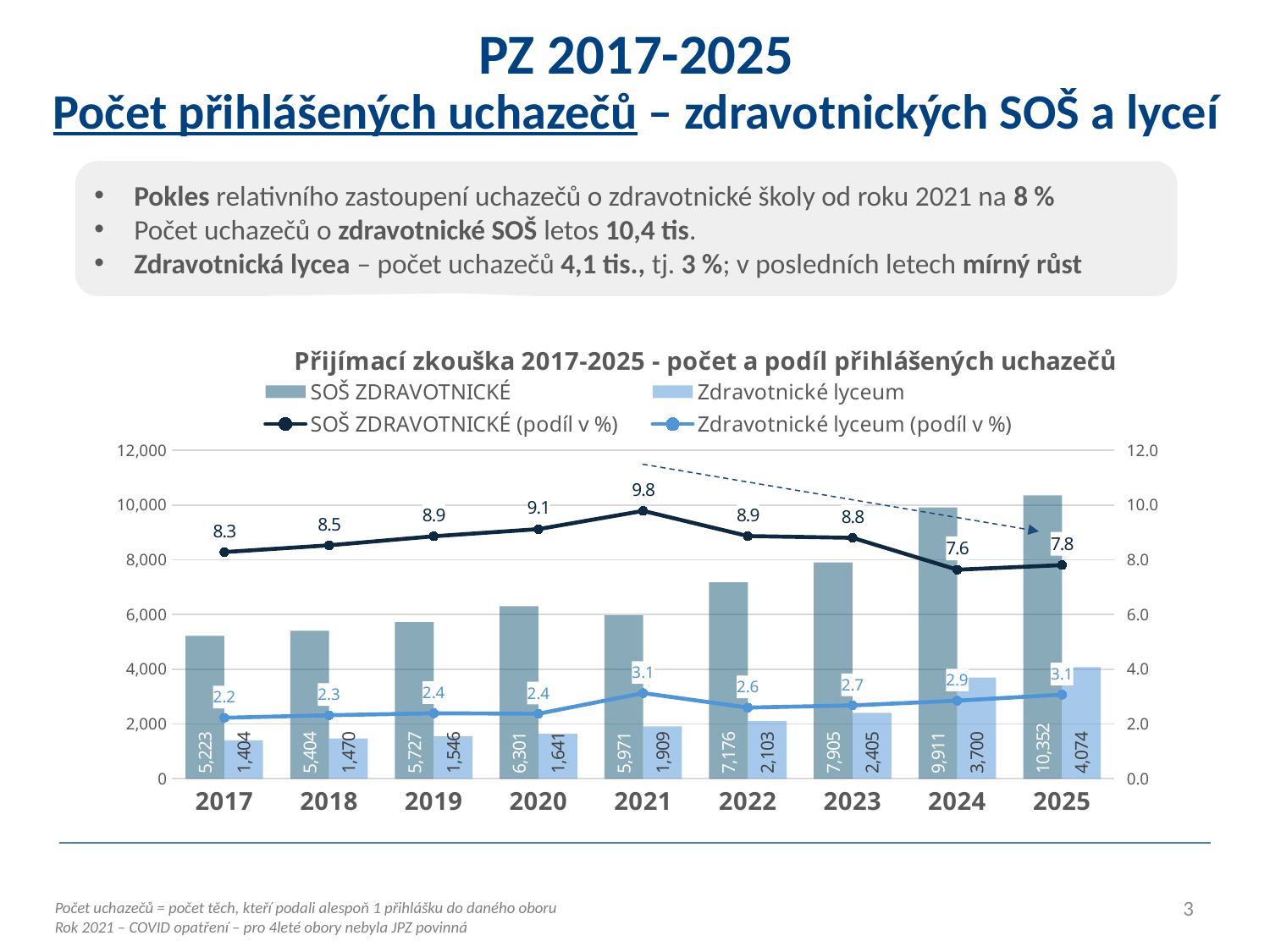
How many series does the chart legend list? 4 What is the Zdravotnické lyceum share (podíl v %) in 2025? 3.1 Do the Zdravotnické lyceum bar values rise or fall from 2017 to 2025? rise In which year is the SOŠ ZDRAVOTNICKÉ share (podíl v %) lowest? 2024 In which year is the SOŠ ZDRAVOTNICKÉ share (podíl v %) highest? 2021 Is the value for SOŠ ZDRAVOTNICKÉ in 2024 greater or less than 8,000? greater What is the difference between the SOŠ ZDRAVOTNICKÉ values for 2025 and 2024? 441 How many years are shown on the x axis of the chart? 9 What is the SOŠ ZDRAVOTNICKÉ share (podíl v %) in 2021? 9.8 What is the value for SOŠ ZDRAVOTNICKÉ in 2025? 10,352 What is the value for Zdravotnické lyceum in 2021? 1,909 Which year has the larger SOŠ ZDRAVOTNICKÉ value, 2020 or 2021? 2020